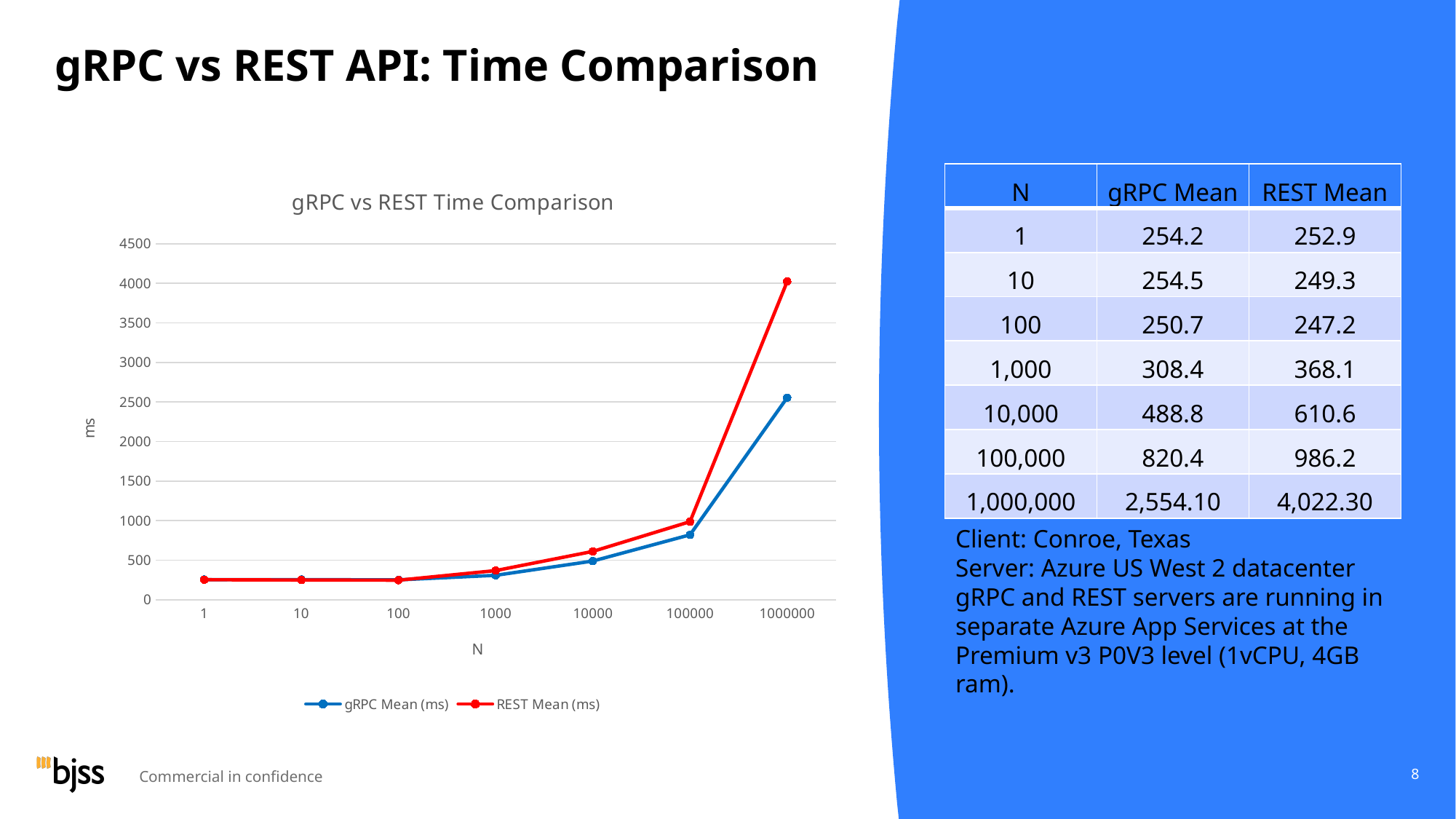
Do the gRPC Mean values rise or fall as N increases from 1,000 to 1,000,000? rise At which N is the REST Mean time lowest? 100 At N = 1,000,000, which is larger, the gRPC Mean or the REST Mean? REST Mean What is the gRPC Mean time at N = 1,000,000? 2,554.10 What colour is the REST Mean (ms) line in the chart? red What is the REST Mean time at N = 10,000? 610.6 How many series does the chart legend list? 2 Is the REST Mean value at N = 1,000,000 greater or less than 3500 ms? greater At which N is the REST Mean time highest? 1,000,000 How many N values are plotted along the x axis of the chart? 7 What kind of chart is shown on the slide? line chart What is the difference between the REST Mean and gRPC Mean at N = 100,000? 165.8